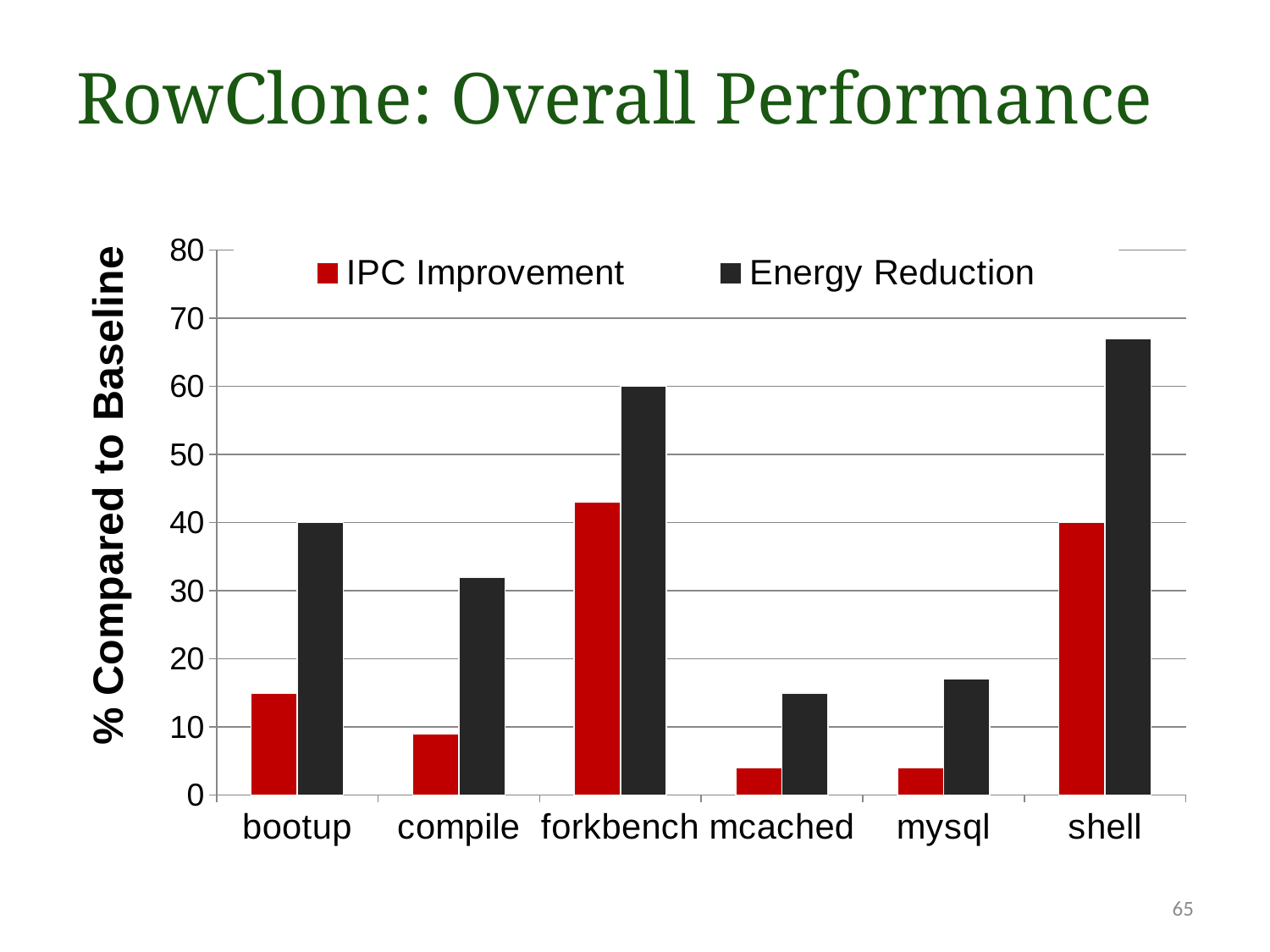
Is the Energy Reduction for shell greater or less than 60? greater Which is larger for compile: IPC Improvement or Energy Reduction? Energy Reduction How many workloads (categories) are shown on the x axis? 6 Is the IPC Improvement for mcached greater or less than 10? less What is the label on the y axis? % Compared to Baseline Which workload has the highest Energy Reduction? shell Which workload has the larger Energy Reduction, forkbench or bootup? forkbench How many series does the legend list? 2 Is the Energy Reduction for mysql greater or less than 20? less What kind of chart is shown on the slide? bar chart Which workload has the highest IPC Improvement? forkbench